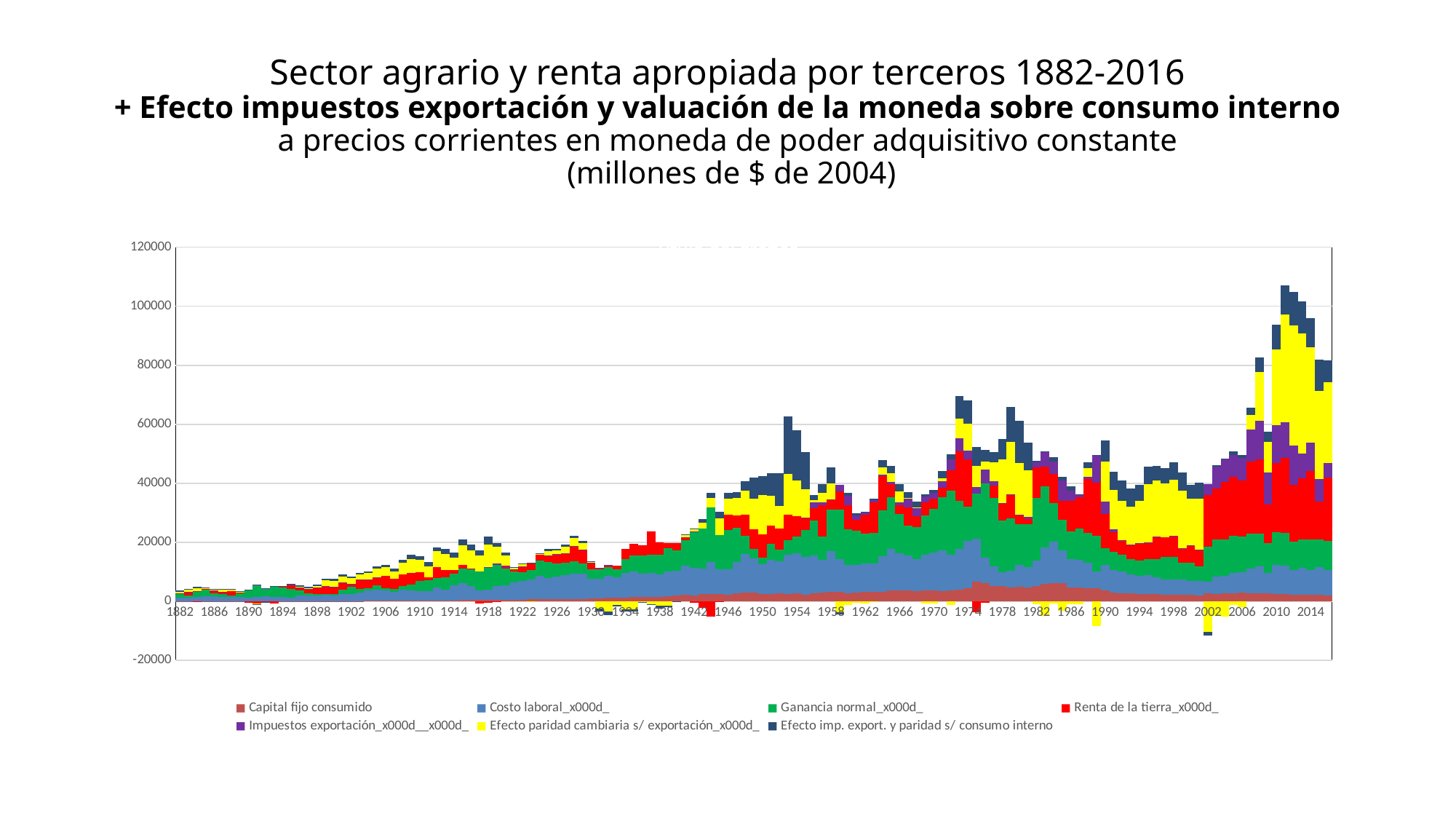
How many series does the legend list? 7 Do the stacked totals generally rise or fall from 1882 to 2016? rise What is the highest value shown on the vertical axis? 120000 Is the stacked total for 1998 greater or less than 60000? less Is the stacked total for 1950 greater or less than 20000? greater Which series is shown in red in the legend? Renta de la tierra_x000d_ Is the stacked total for 1882 greater or less than 20000? less What kind of chart is shown on the slide? Stacked bar chart In which decade does the tallest stacked bar occur? 2010s What is the lowest value shown on the vertical axis? -20000 Which series is shown in yellow in the legend? Efecto paridad cambiaria s/ exportación_x000d_